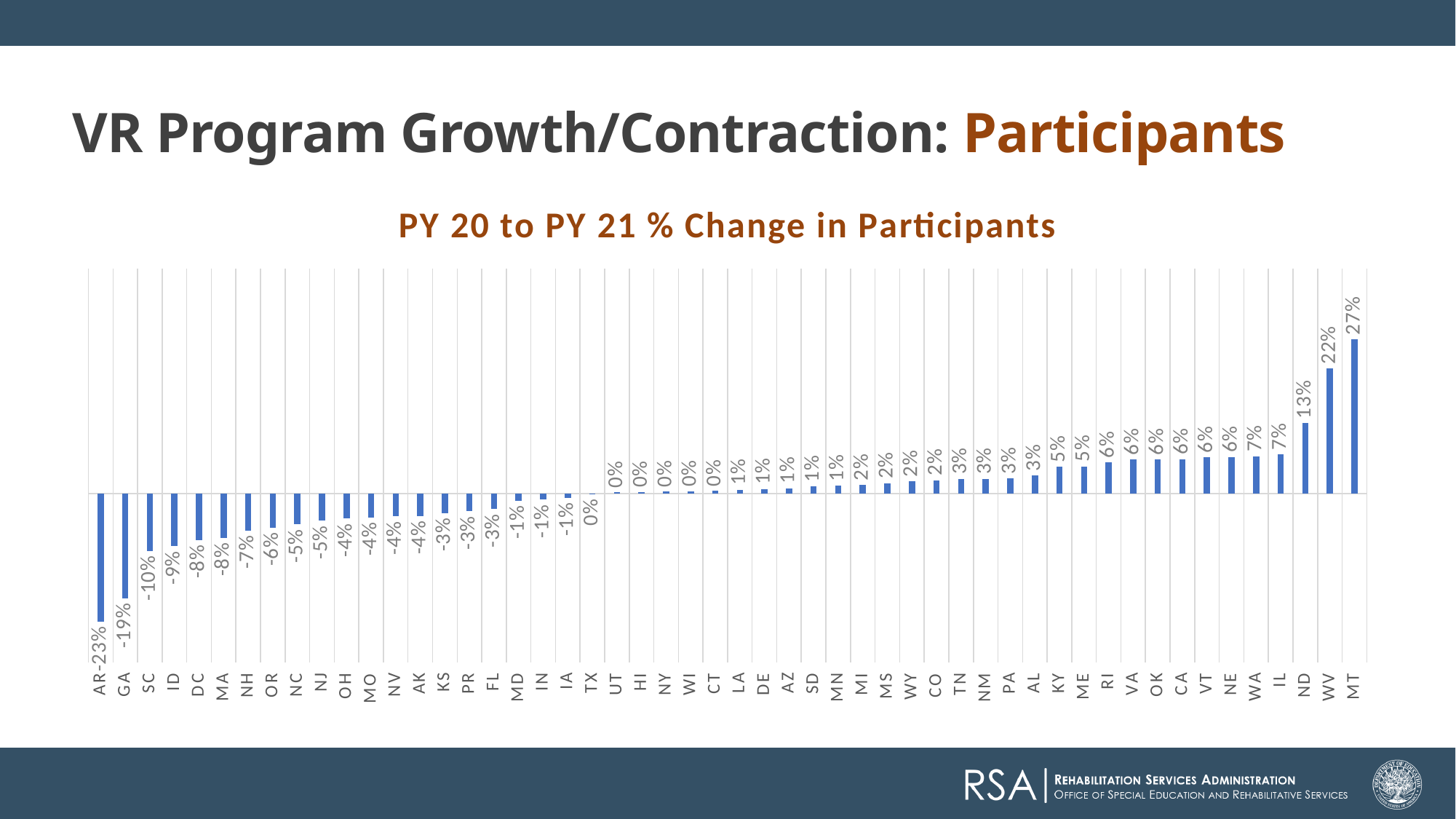
What is the difference between the % change in participants for MT and WV? 5% How many states/territories are shown on the x axis of the chart? 52 What is the PY 20 to PY 21 % change in participants for ND? 13% Do the values rise or fall moving from left to right along the x axis? Rise What type of chart is shown on the slide? Bar chart What is the PY 20 to PY 21 % change in participants for MT? 27% What is the PY 20 to PY 21 % change in participants for SC? -10% What is the PY 20 to PY 21 % change in participants for AR? -23% Which state has the highest PY 20 to PY 21 % change in participants? MT Which state has the lowest PY 20 to PY 21 % change in participants? AR What is the difference between the % change in participants for GA and AR? 4% Which has a larger % change in participants, WV or ND? WV